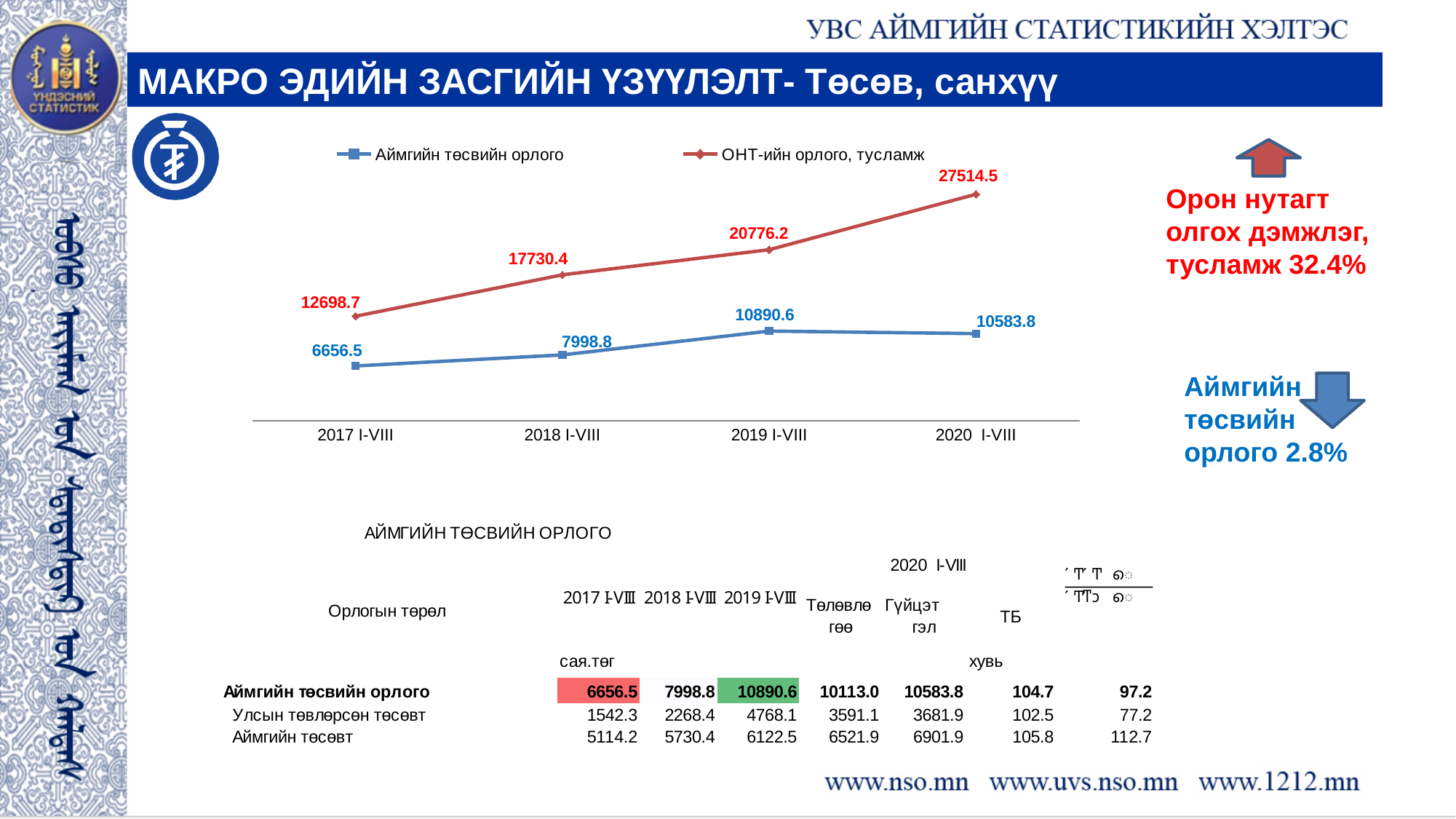
How many periods are shown on the x axis of the chart? 4 What is the value of ОНТ-ийн орлого, тусламж for 2020 I-VIII? 27514.5 Which colour is used for the ОНТ-ийн орлого, тусламж line? red In which period is Аймгийн төсвийн орлого highest? 2019 I-VIII What is the difference between ОНТ-ийн орлого, тусламж and Аймгийн төсвийн орлого in 2020 I-VIII? 16930.7 Does ОНТ-ийн орлого, тусламж rise or fall from 2017 I-VIII to 2020 I-VIII? rise What kind of chart is shown on the slide? line chart In which period is ОНТ-ийн орлого, тусламж lowest? 2017 I-VIII Which series has the larger value in 2019 I-VIII, Аймгийн төсвийн орлого or ОНТ-ийн орлого, тусламж? ОНТ-ийн орлого, тусламж How many series does the chart legend list? 2 What is the value of ОНТ-ийн орлого, тусламж for 2018 I-VIII? 17730.4 What is the value of Аймгийн төсвийн орлого for 2017 I-VIII? 6656.5